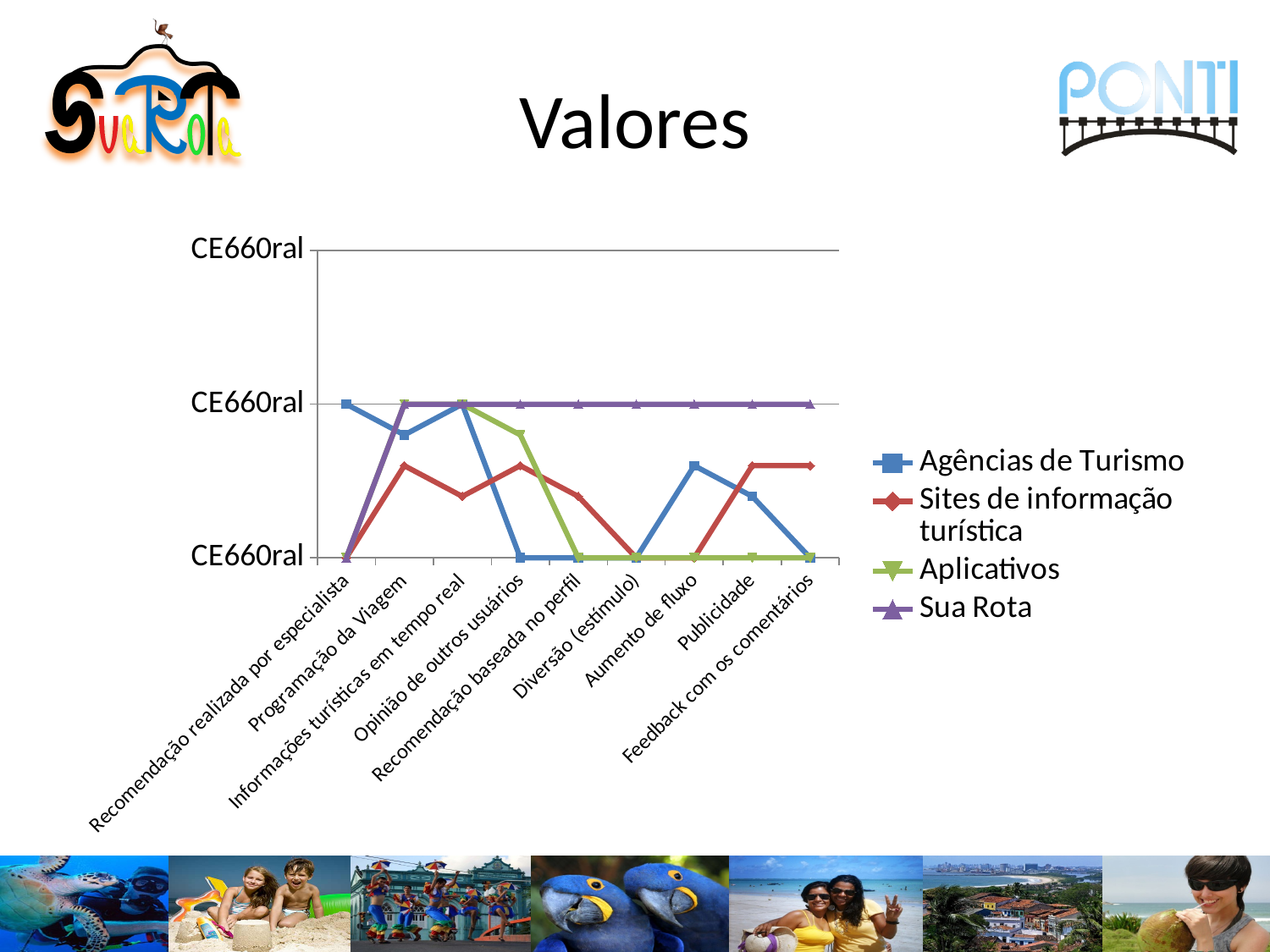
Which series is represented by the purple line with triangle markers? Sua Rota How many categories are shown along the x axis? 9 At "Feedback com os comentários", which series is higher: Sites de informação turística or Aplicativos? Sites de informação turística At "Aumento de fluxo", which series is higher: Agências de Turismo or Sites de informação turística? Agências de Turismo At "Publicidade", which series is higher: Agências de Turismo or Aplicativos? Agências de Turismo What kind of chart is shown on the slide? line chart How many series does the legend list? 4 What is the title of the slide containing the chart? Valores Does the Sua Rota line rise or fall between "Recomendação realizada por especialista" and "Programação da Viagem"? rise Does the Aplicativos line rise or fall between "Opinião de outros usuários" and "Recomendação baseada no perfil"? fall At "Diversão (estímulo)", which series has the highest value? Sua Rota